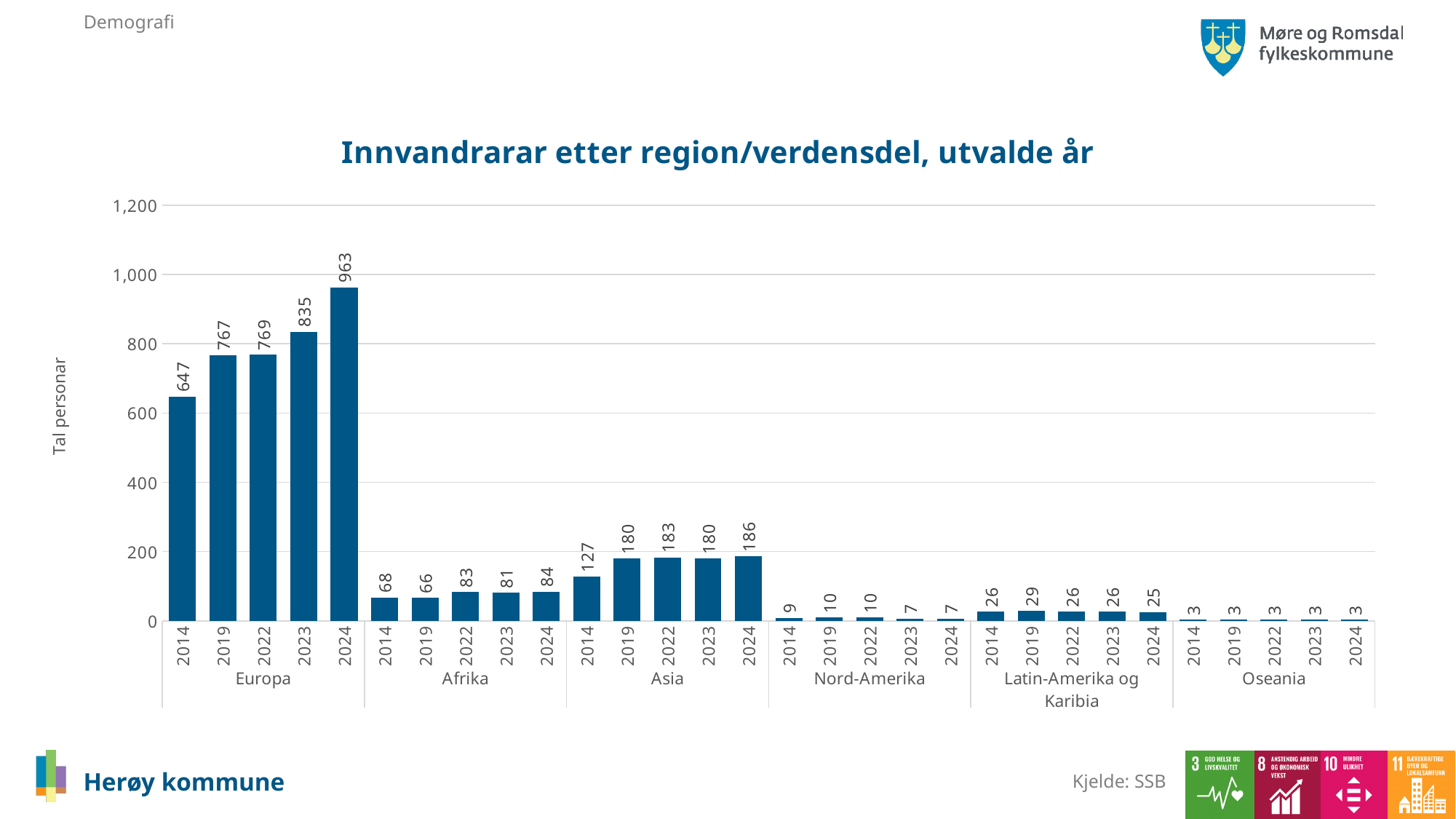
What kind of chart is shown on the slide? bar chart Which region has the lowest values on the chart? Oseania Is the value for Europa in 2023 greater or less than 800? greater What is the title of the chart? Innvandrarar etter region/verdensdel, utvalde år What is the value for Latin-Amerika og Karibia in 2019? 29 Which region has the highest bar on the chart? Europa Which is larger: Afrika in 2024 or Asia in 2014? Asia in 2014 What is the difference between the Europa values for 2024 and 2014? 316 What is the value for Asia in 2014? 127 What is the value for Europa in 2024? 963 How many regions are shown on the x axis? 6 What is the value for Nord-Amerika in 2023? 7